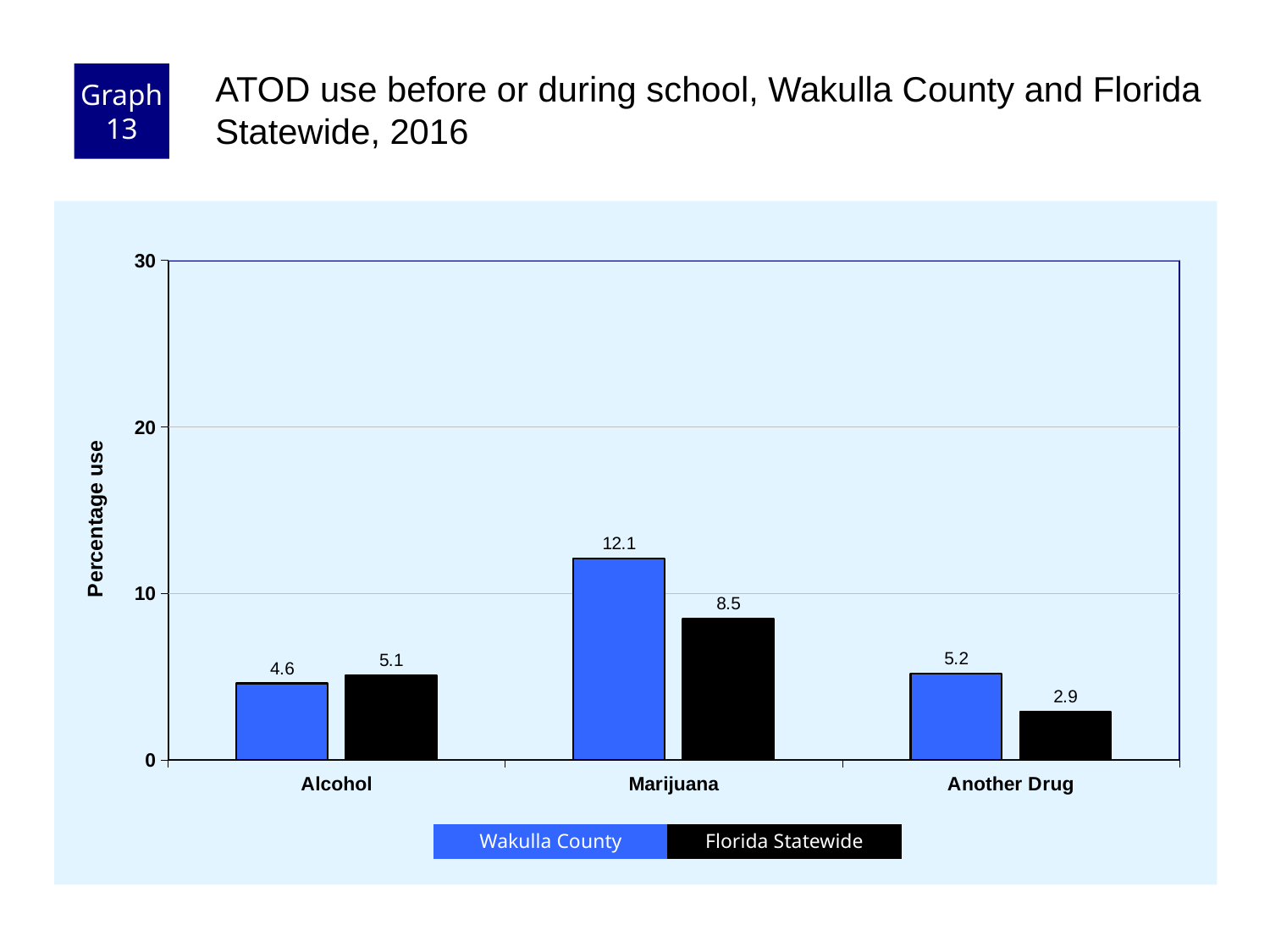
What is the Florida Statewide value for Another Drug? 2.9 What is the Florida Statewide value for Alcohol? 5.1 What is the difference between the Wakulla County and Florida Statewide values for Marijuana? 3.6 What is the Wakulla County value for Marijuana? 12.1 What is the label of the y axis? Percentage use How many series does the legend list? 2 Is the Wakulla County value for Marijuana greater or less than 10? greater Which is larger for Alcohol, the Wakulla County value or the Florida Statewide value? Florida Statewide Which category has the lowest Florida Statewide value? Another Drug How many categories are shown on the x axis? 3 Which category has the highest Wakulla County value? Marijuana What kind of chart is shown on the slide? bar chart